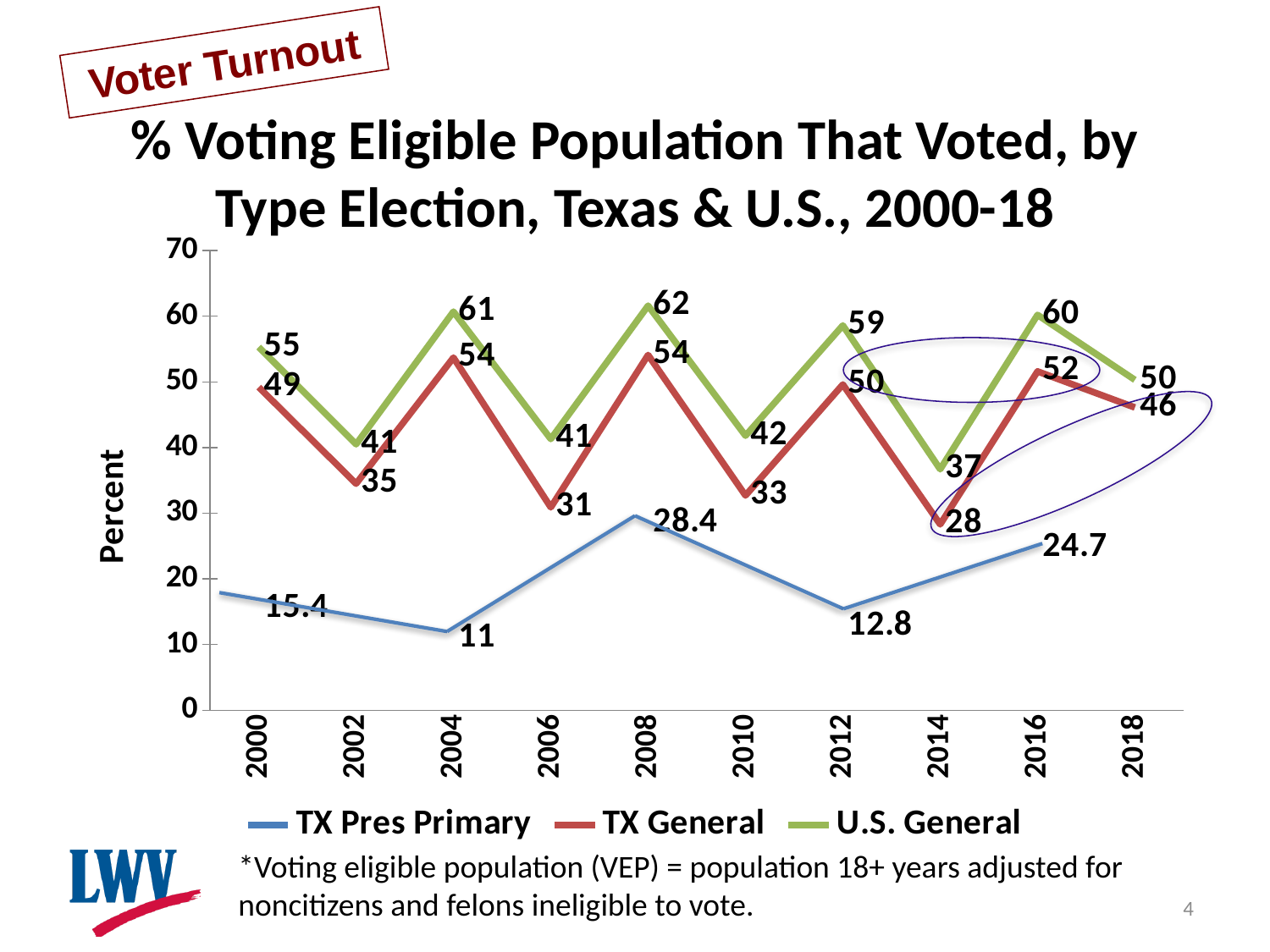
In which year was the TX General turnout lowest? 2014 In which year was the TX Pres Primary turnout highest? 2008 How many years are shown on the x axis? 10 What is the difference between the U.S. General and TX General turnout in 2018? 4 Did the TX General turnout rise or fall from 2016 to 2018? fall What was the TX General turnout in 2014? 28 How many series does the legend list? 3 What was the U.S. General turnout in 2008? 62 What is the label on the y axis? Percent What type of chart is shown on the slide? line chart Which was higher in 2012: TX General or U.S. General turnout? U.S. General What was the TX Pres Primary turnout in 2016? 24.7